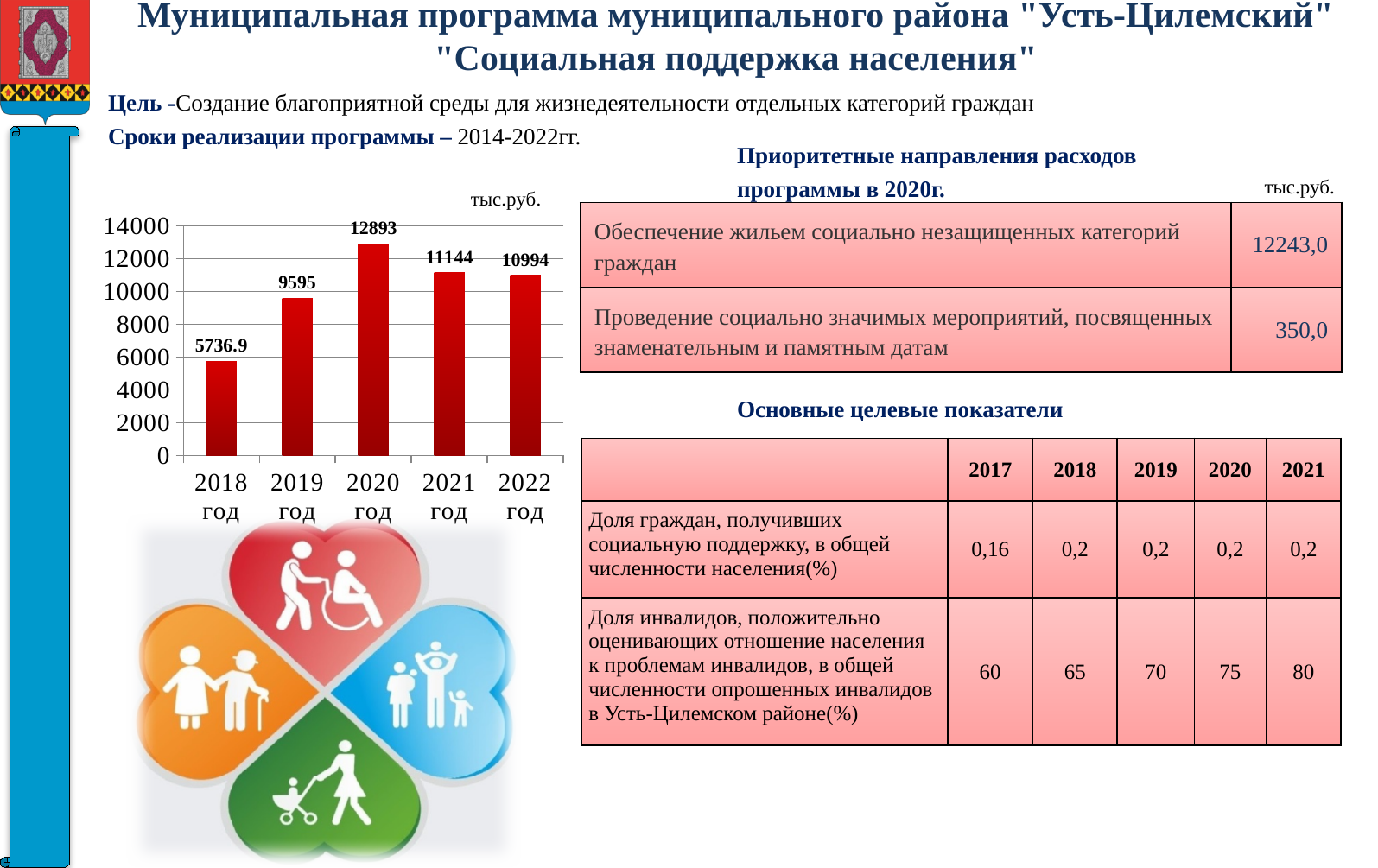
Which year has the highest value in the bar chart? 2020 год What kind of chart is shown on the slide? bar chart What is the value for 2018 год in the bar chart? 5736.9 What is the difference between the values for 2020 год and 2021 год in the bar chart? 1749 Which year has the lowest value in the bar chart? 2018 год Which is larger in the bar chart, the value for 2021 год or the value for 2022 год? 2021 год How many years are shown in the bar chart? 5 What is the value for 2022 год in the bar chart? 10994 What unit is indicated above the bar chart? тыс.руб. Is the value for 2019 год in the bar chart greater or less than 10000? less What is the value for 2020 год in the bar chart? 12893 What is the difference between the values for 2019 год and 2018 год in the bar chart? 3858.1